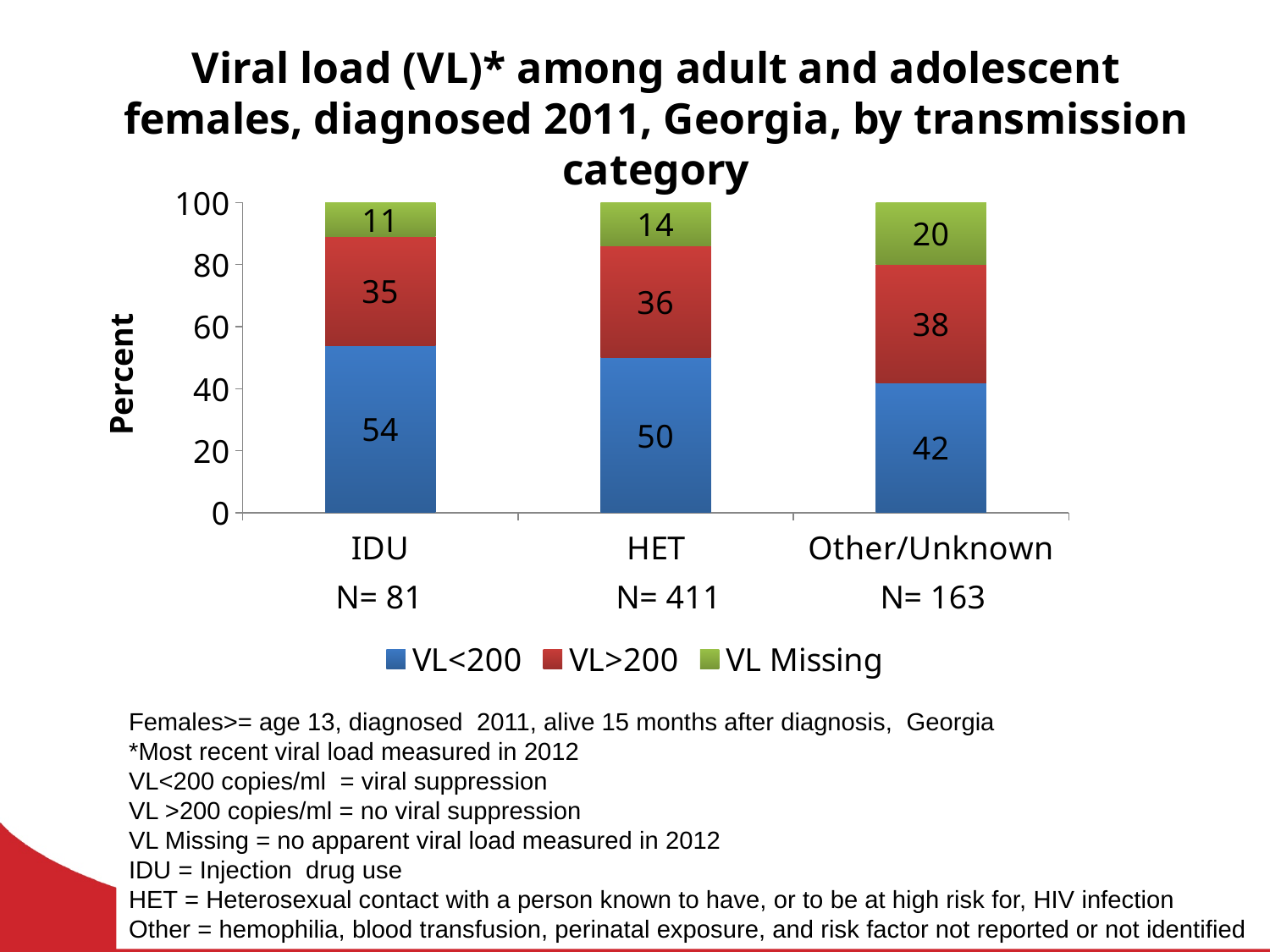
Which is larger, the VL Missing value for HET or for Other/Unknown? Other/Unknown What is the difference between the VL<200 values for IDU and Other/Unknown? 12 Which transmission category has the highest VL<200 value? IDU What is the VL Missing value for Other/Unknown? 20 What kind of chart is shown? Stacked bar chart What is the VL<200 value for IDU? 54 How many transmission categories are shown on the x axis? 3 What is the VL>200 value for HET? 36 What is the label on the y axis? Percent How many series does the legend list? 3 What is the total of the stacked bar for HET? 100 Which transmission category has the lowest VL Missing value? IDU